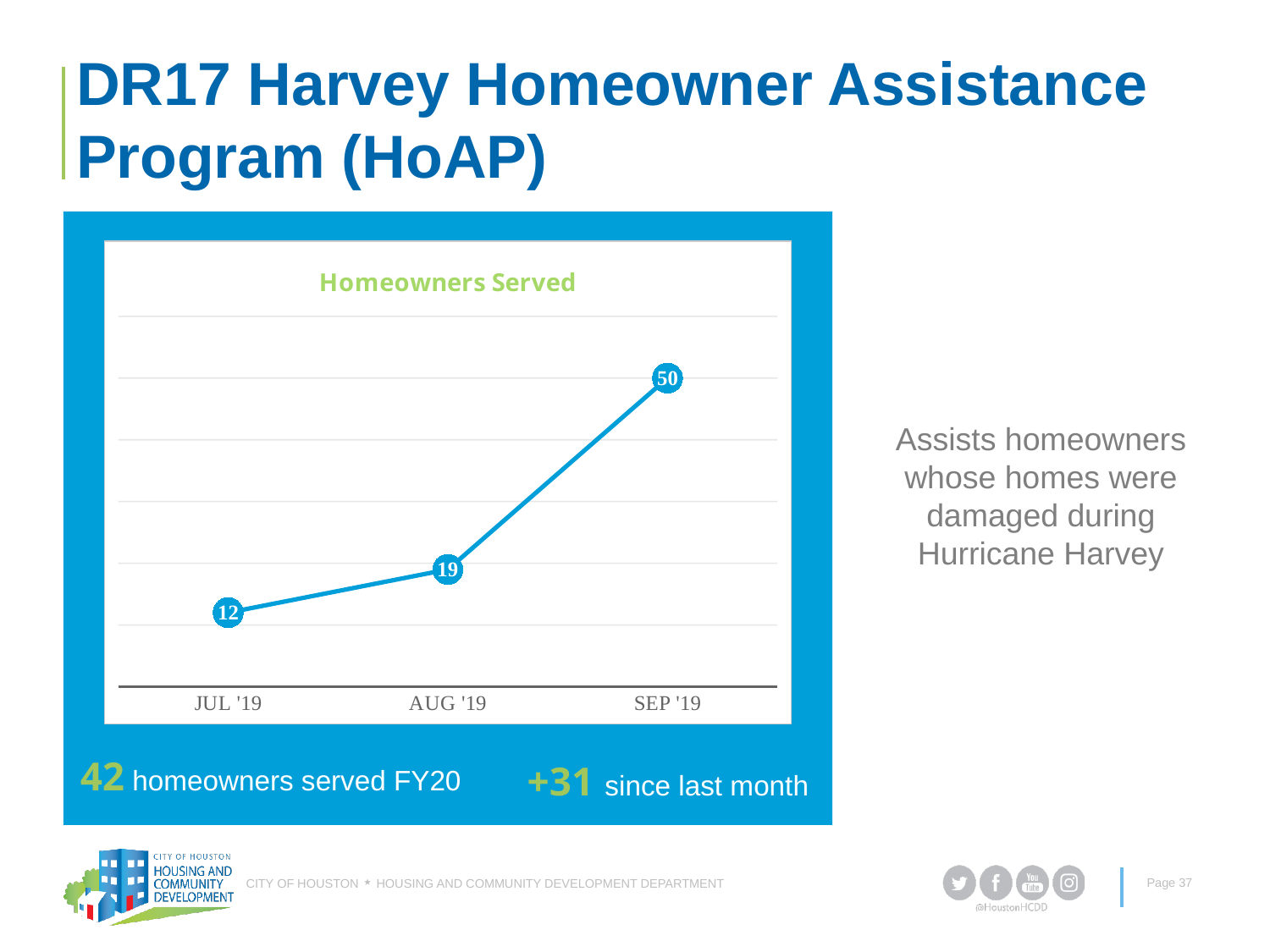
Which month has the highest number of homeowners served? SEP '19 What kind of chart is shown on the slide? Line chart What is the value for SEP '19 in the Homeowners Served chart? 50 Which is larger, the value for AUG '19 or the value for JUL '19? AUG '19 Do the values rise or fall from JUL '19 to SEP '19? Rise What is the difference between the values for AUG '19 and JUL '19? 7 What is the value for JUL '19 in the Homeowners Served chart? 12 How many data points are plotted in the Homeowners Served chart? 3 Which month has the lowest number of homeowners served? JUL '19 What is the value for AUG '19 in the Homeowners Served chart? 19 What is the difference between the values for SEP '19 and AUG '19? 31 What is the title of the chart? Homeowners Served